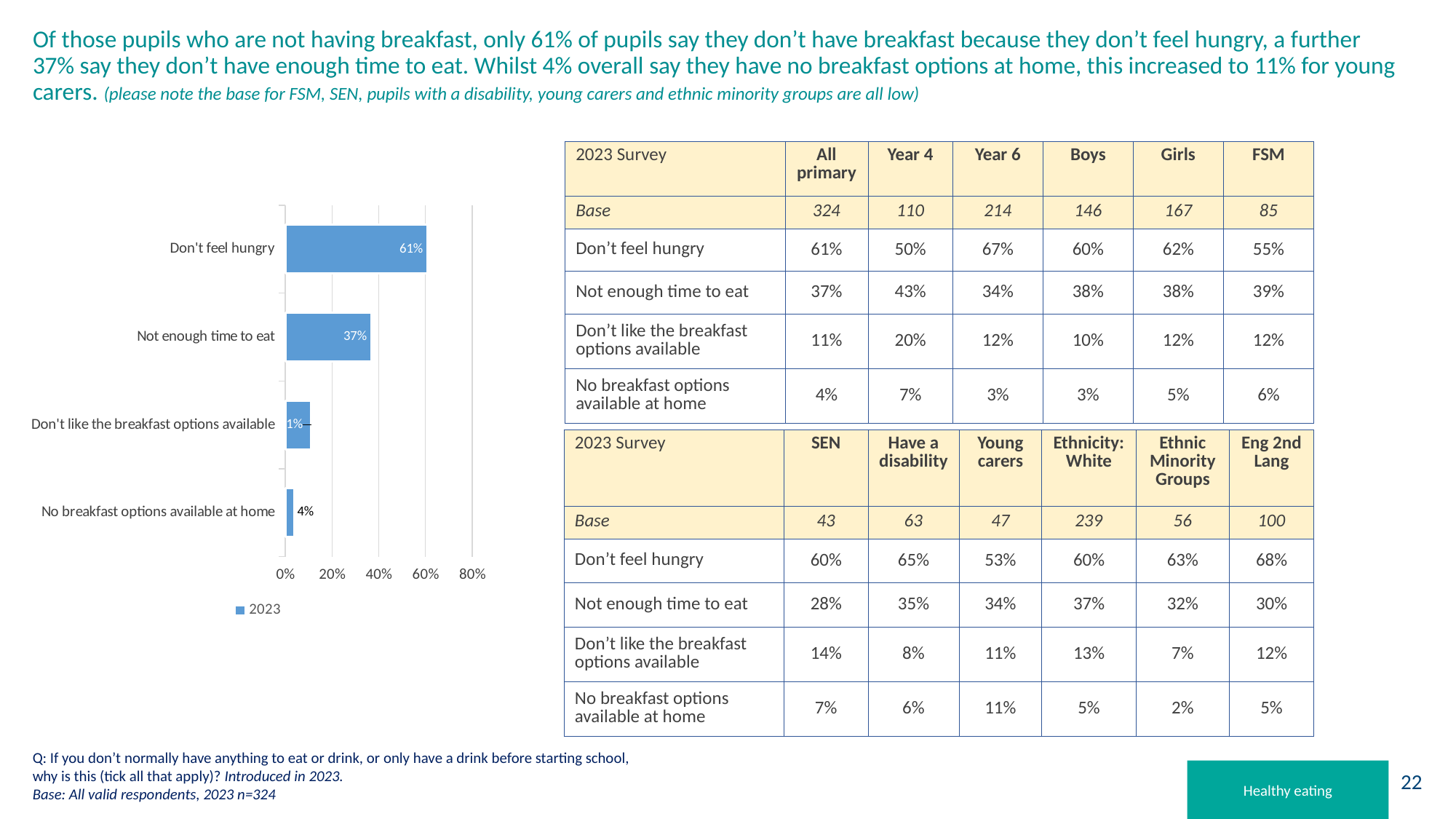
In the bar chart, is the value for 'Don't like the breakfast options available' greater or less than 20%? less In the bar chart, which is larger: 'Not enough time to eat' or 'No breakfast options available at home'? Not enough time to eat In the bar chart, what is the value for 'Not enough time to eat'? 37% In the bar chart, what is the value for 'No breakfast options available at home'? 4% In the bar chart, how many percentage points higher is 'Don't feel hungry' than 'Not enough time to eat'? 24 percentage points Which category has the lowest value in the bar chart? No breakfast options available at home In the bar chart, what is the difference between 'Not enough time to eat' and 'No breakfast options available at home'? 33 percentage points How many series does the bar chart's legend list? 1 What type of chart is shown on the left of the slide? Bar chart Which category has the highest value in the bar chart? Don't feel hungry What percentage of pupils say they don't have breakfast because they don't feel hungry, according to the bar chart? 61% How many categories are shown in the bar chart? 4